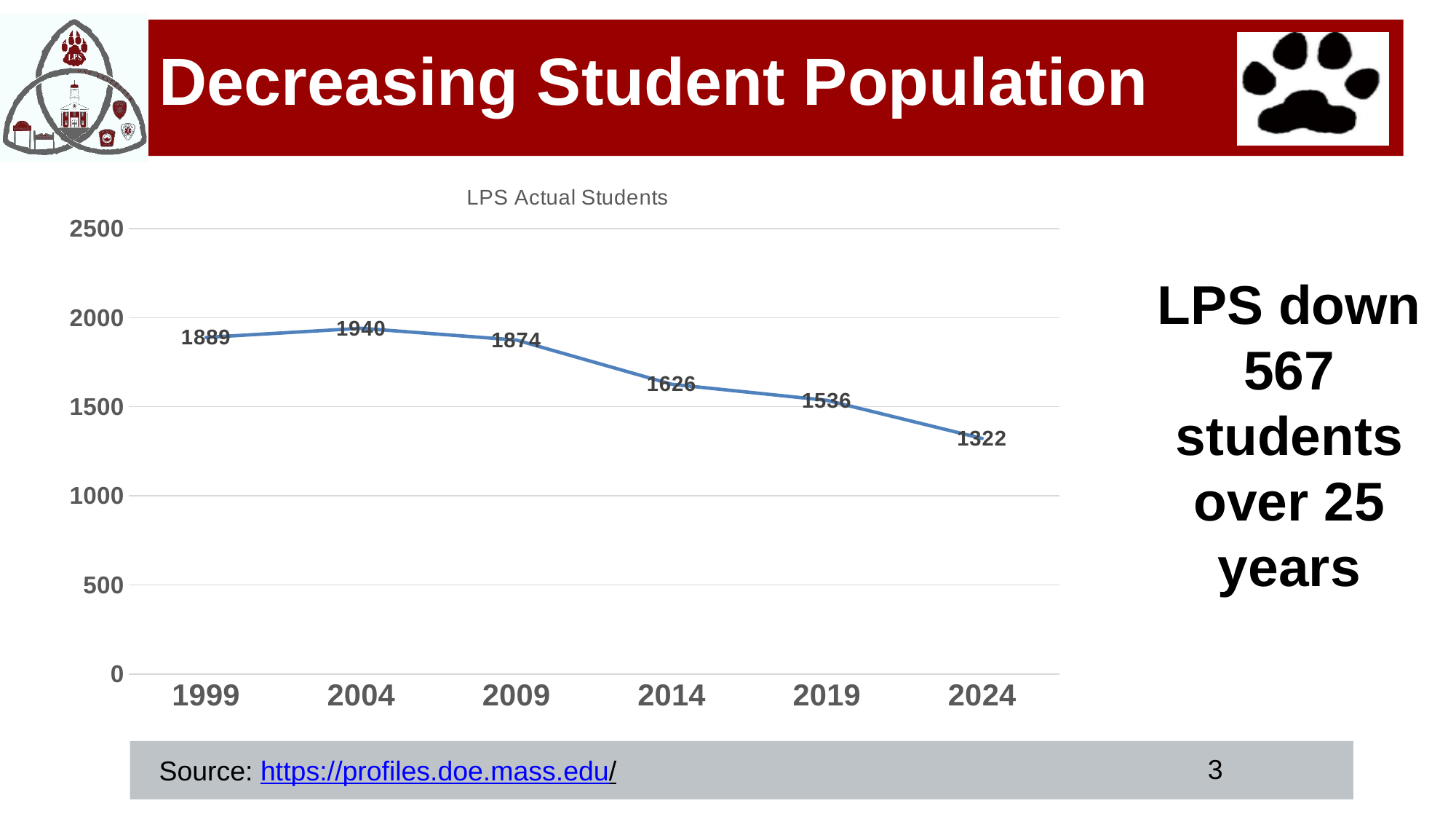
Do the values in the LPS Actual Students chart rise or fall from 2004 to 2024? fall What is the value for 1999 in the LPS Actual Students chart? 1889 Which year has the lowest value in the LPS Actual Students chart? 2024 What is the value for 2014 in the LPS Actual Students chart? 1626 Is the value for 2019 in the LPS Actual Students chart greater or less than 1500? greater What is the difference between the values for 2004 and 2009 in the LPS Actual Students chart? 66 What is the difference between the values for 1999 and 2024 in the LPS Actual Students chart? 567 How many years are plotted in the LPS Actual Students chart? 6 Which is larger in the LPS Actual Students chart, the value for 2014 or the value for 2019? 2014 What kind of chart is the LPS Actual Students chart? line chart Which year has the highest value in the LPS Actual Students chart? 2004 What is the value for 2024 in the LPS Actual Students chart? 1322